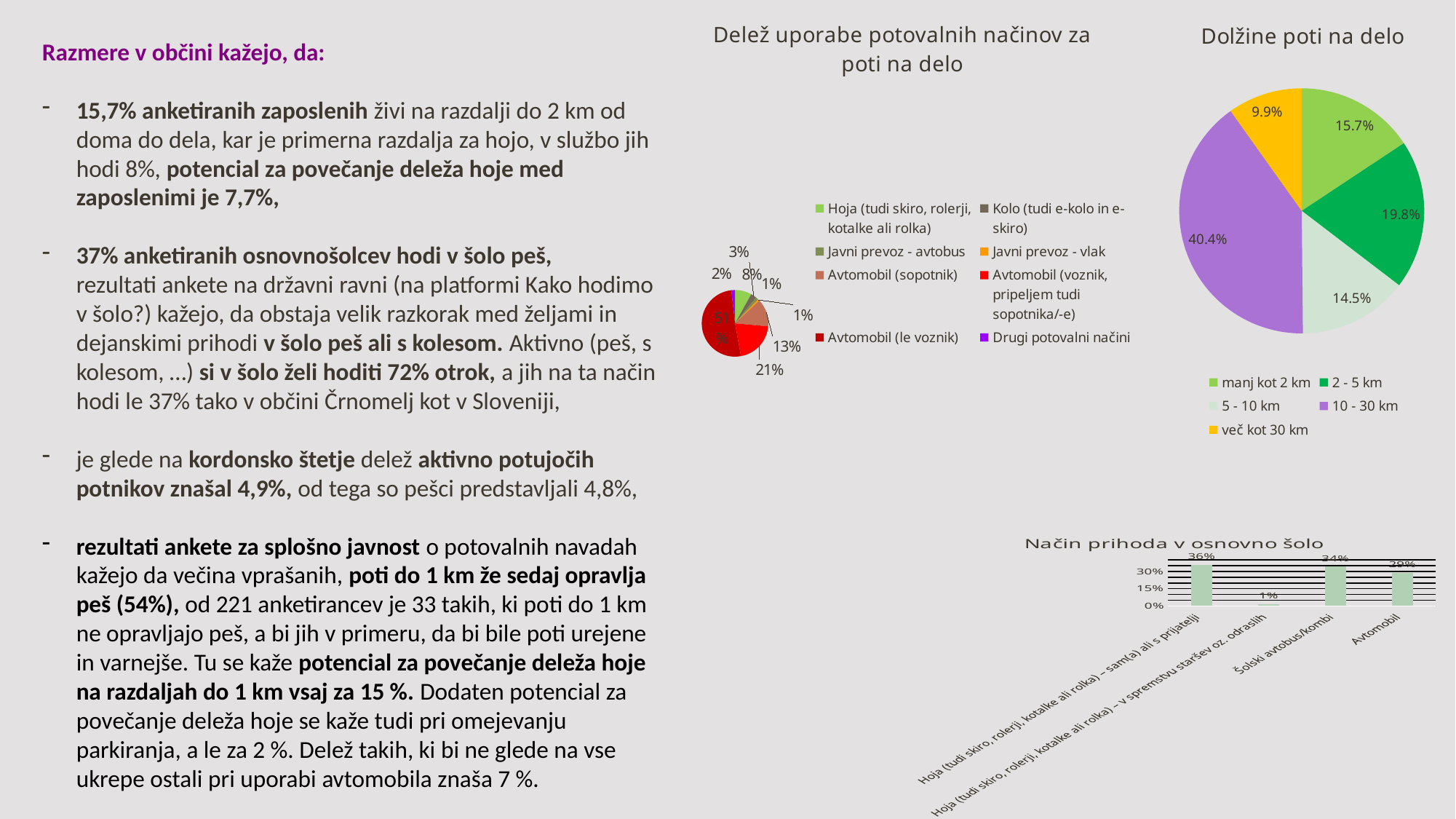
In the chart titled "Dolžine poti na delo", which category has the largest slice? 10 - 30 km In the chart titled "Dolžine poti na delo", what share of the pie is the "10 - 30 km" slice? 40.4% In the chart titled "Način prihoda v osnovno šolo", what is the value for "Šolski avtobus/kombi"? 34% In the chart titled "Dolžine poti na delo", how many categories does the legend list? 5 In the chart titled "Način prihoda v osnovno šolo", which category has the lowest value? Hoja (tudi skiro, rolerji, kotalke ali rolka) – v spremstvu staršev oz. odraslih In the chart titled "Način prihoda v osnovno šolo", what is the difference between the value for "Avtomobil" and the value for "Šolski avtobus/kombi"? 5% In the chart titled "Dolžine poti na delo", which category has the smallest slice? več kot 30 km In the chart titled "Dolžine poti na delo", which is larger: "manj kot 2 km" or "2 - 5 km"? 2 - 5 km In the chart titled "Delež uporabe potovalnih načinov za poti na delo", how many entries does the legend list? 8 What kind of chart is "Način prihoda v osnovno šolo"? bar chart In the chart titled "Dolžine poti na delo", what is the value for "manj kot 2 km"? 15.7% In the chart titled "Dolžine poti na delo", what is the difference between the "2 - 5 km" and "5 - 10 km" slices? 5.3%